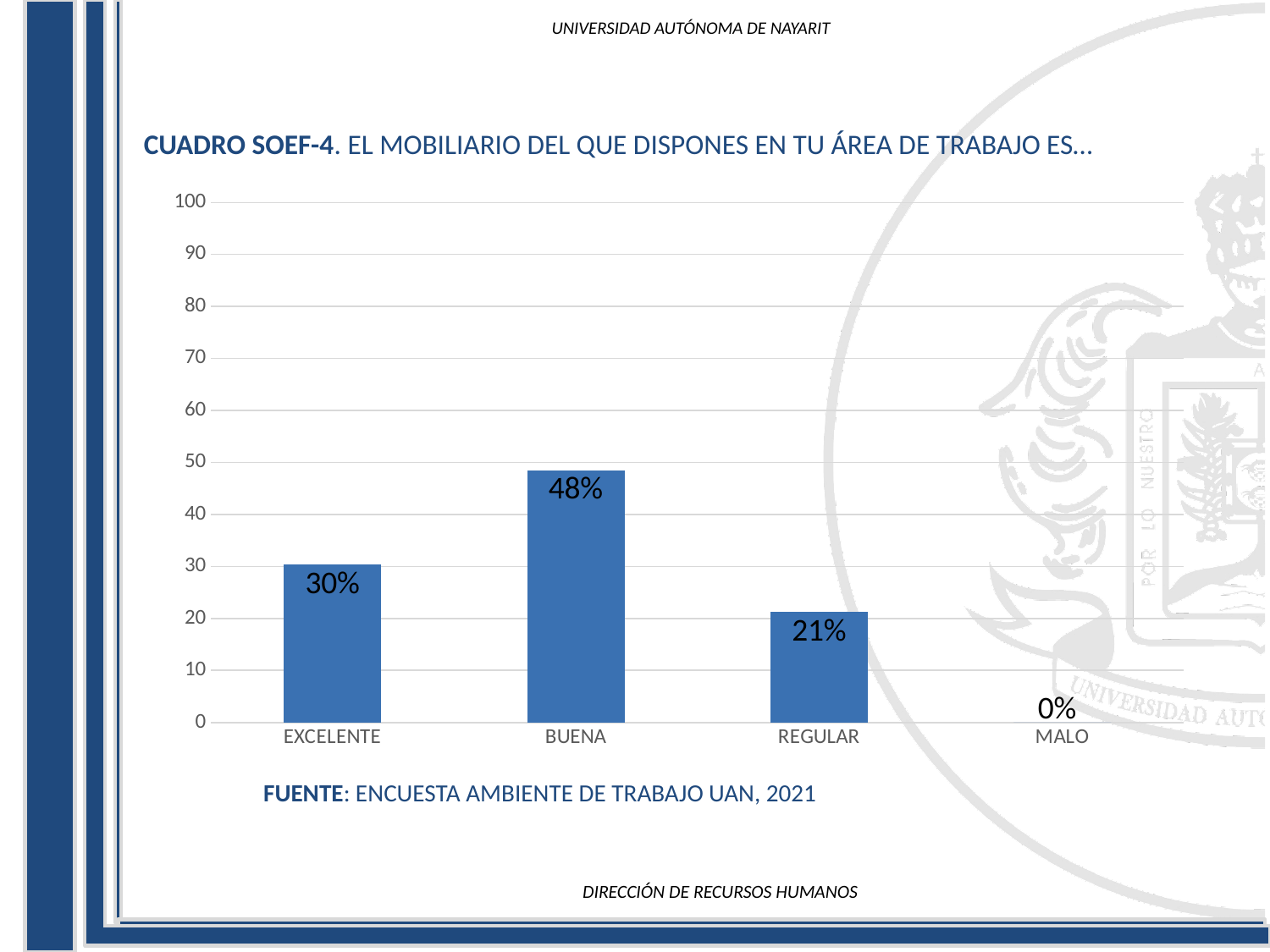
How many categories are shown on the x axis? 4 Which is larger, the value for EXCELENTE or the value for REGULAR? EXCELENTE Which category has the lowest value? MALO What is the value for EXCELENTE? 30% What is the value for BUENA? 48% What is the value for REGULAR? 21% Is the value for BUENA greater or less than 40? greater What is the difference between the values for BUENA and EXCELENTE? 18% Which category has the highest value? BUENA What is the value for MALO? 0% What kind of chart is shown on the slide? Bar chart What is the difference between the values for EXCELENTE and REGULAR? 9%